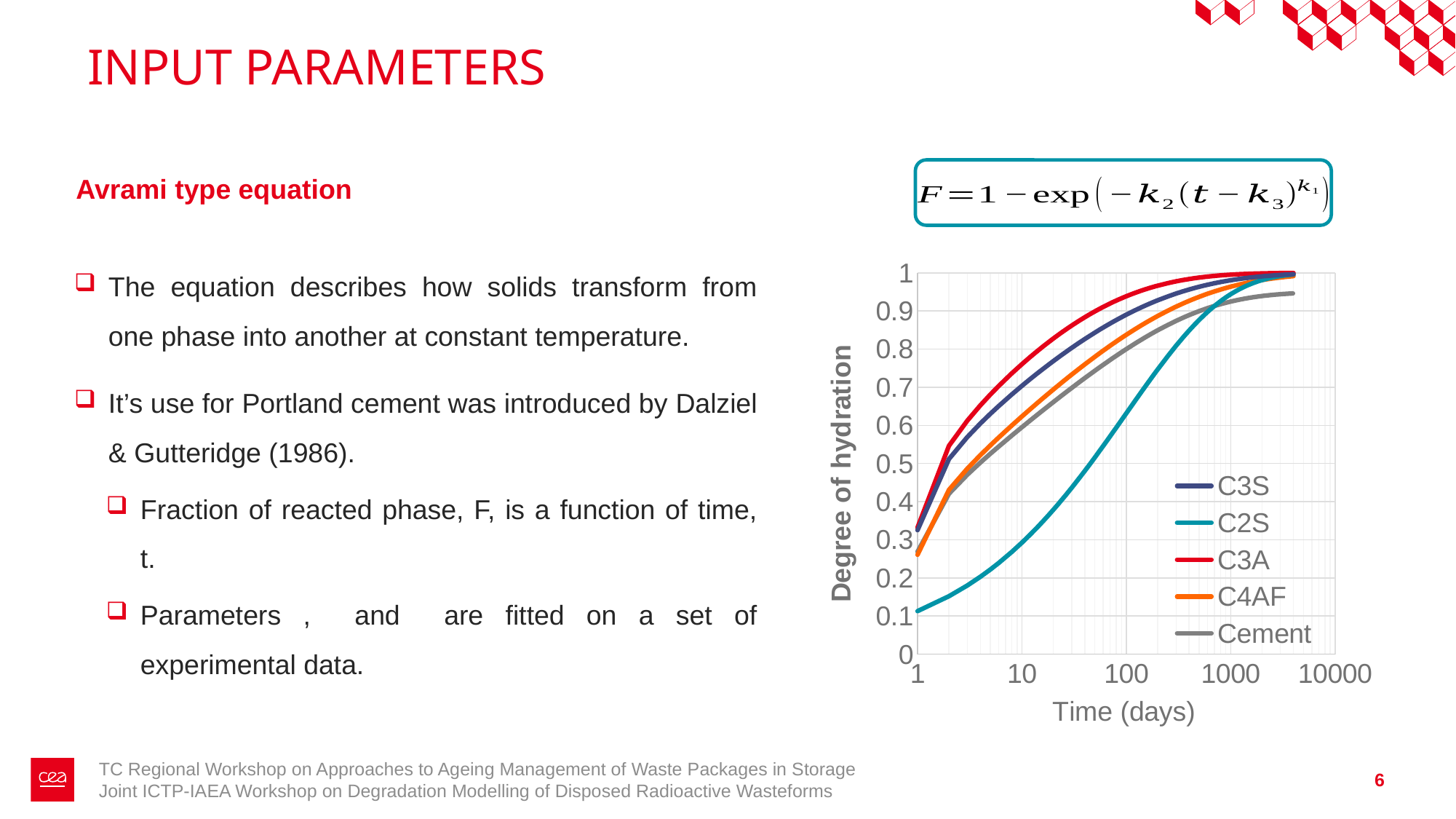
How many series does the chart legend list? 5 Is the degree of hydration for C3A at 10 days greater or less than 0.7? greater What is the label of the x axis of the chart? Time (days) Which series has the highest degree of hydration at 10 days? C3A What is the label of the y axis of the chart? Degree of hydration Which series has the lowest degree of hydration at 1 day? C2S Do the degree of hydration values rise or fall as time increases along the x axis? rise At 10 days, which series has the larger degree of hydration, C3A or C2S? C3A Is the degree of hydration for C2S at 1 day greater or less than 0.2? less What kind of chart is shown on the slide? line chart